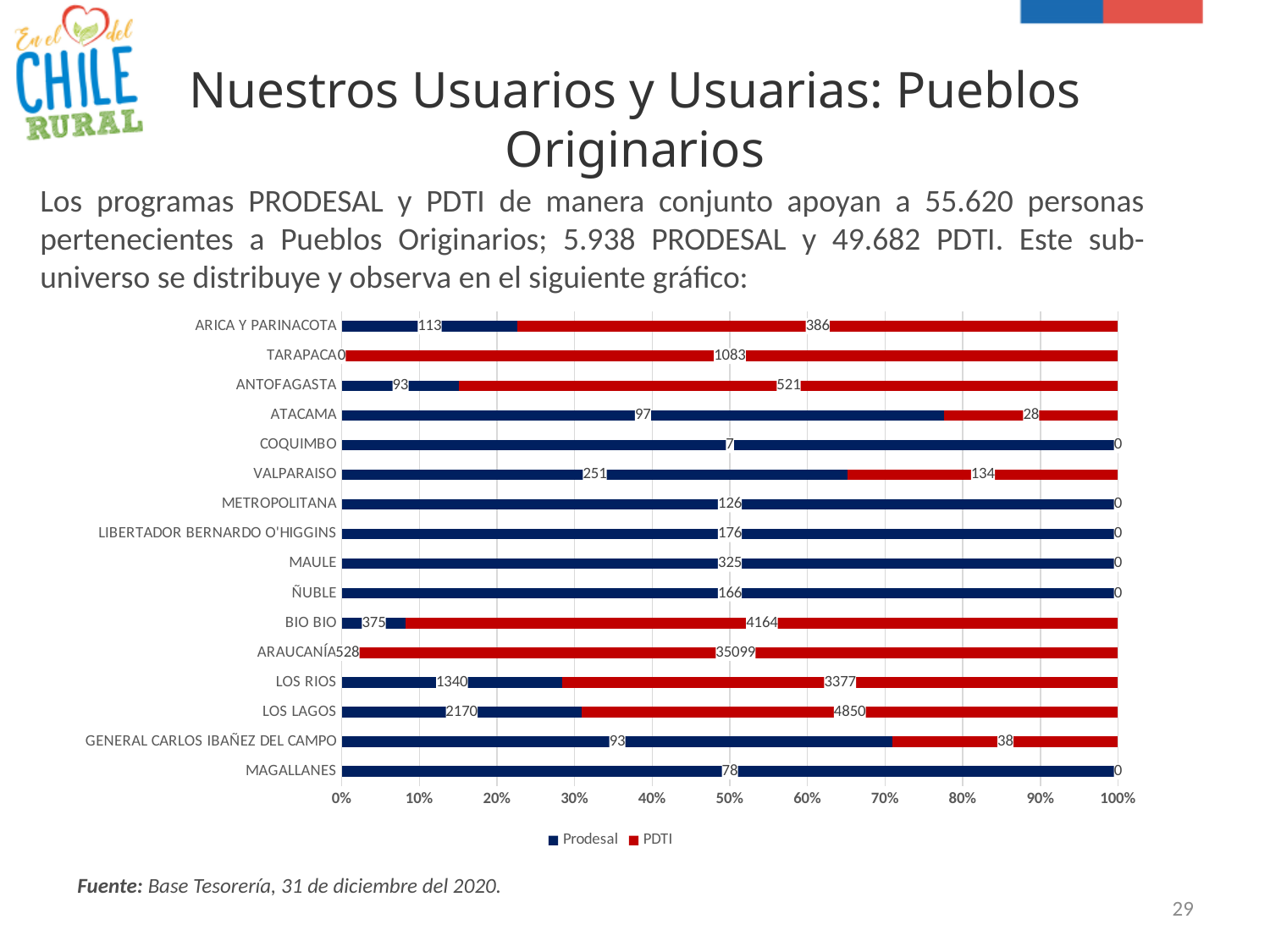
Is the Prodesal share of the bar for VALPARAISO greater or less than 60%? greater Is the Prodesal share of the bar for ARICA Y PARINACOTA greater or less than 30%? less Which is larger, the PDTI value for BIO BIO or the PDTI value for LOS LAGOS? LOS LAGOS What is the Prodesal value for LOS LAGOS? 2170 What is the difference between the PDTI and Prodesal values for LOS LAGOS? 2680 Which region has the highest Prodesal value? LOS LAGOS What is the PDTI value for ARAUCANÍA? 35099 How many series does the legend list? 2 How many regions are shown on the chart? 16 What is the PDTI value for TARAPACA? 1083 Which region has the highest PDTI value? ARAUCANÍA What kind of chart is shown on the slide? Stacked bar chart